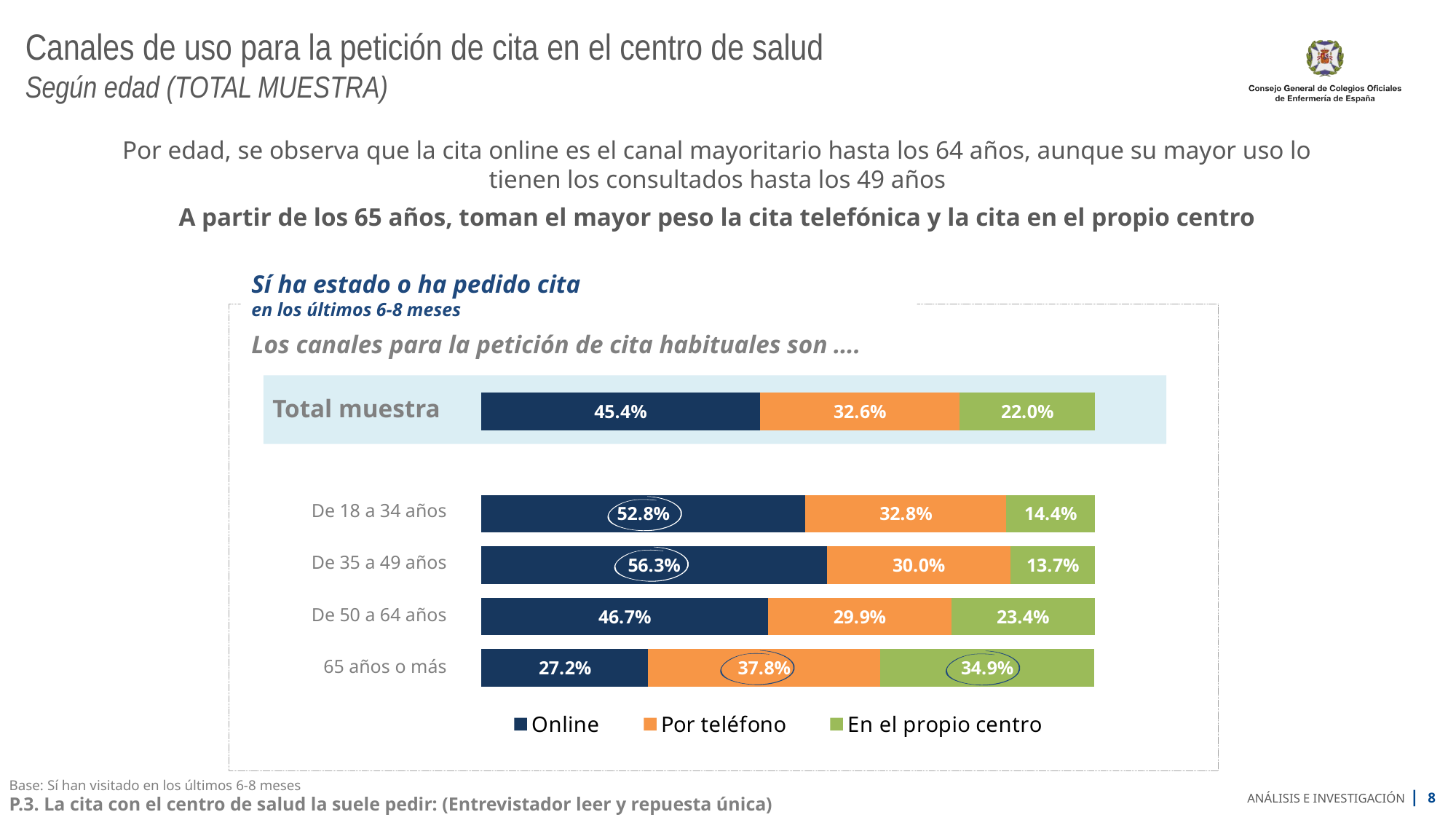
How many age groups are shown in the chart, excluding the 'Total muestra' bar? 4 What is the difference between the Online values for 'De 18 a 34 años' and '65 años o más'? 25.6% What is the total of the 'De 50 a 64 años' stacked bar? 100.0% What kind of chart is shown on the slide? Stacked bar chart Which age group has the lowest 'En el propio centro' value? De 35 a 49 años Which is larger for the '65 años o más' group: the 'Por teléfono' value or the 'En el propio centro' value? Por teléfono How many series does the legend list? 3 Which series is shown in orange in the legend? Por teléfono What is the 'En el propio centro' value for the 'Total muestra' bar? 22.0% What is the 'Por teléfono' value for the '65 años o más' age group? 37.8% What is the Online value for the 'De 35 a 49 años' age group? 56.3% Which age group has the highest Online value? De 35 a 49 años